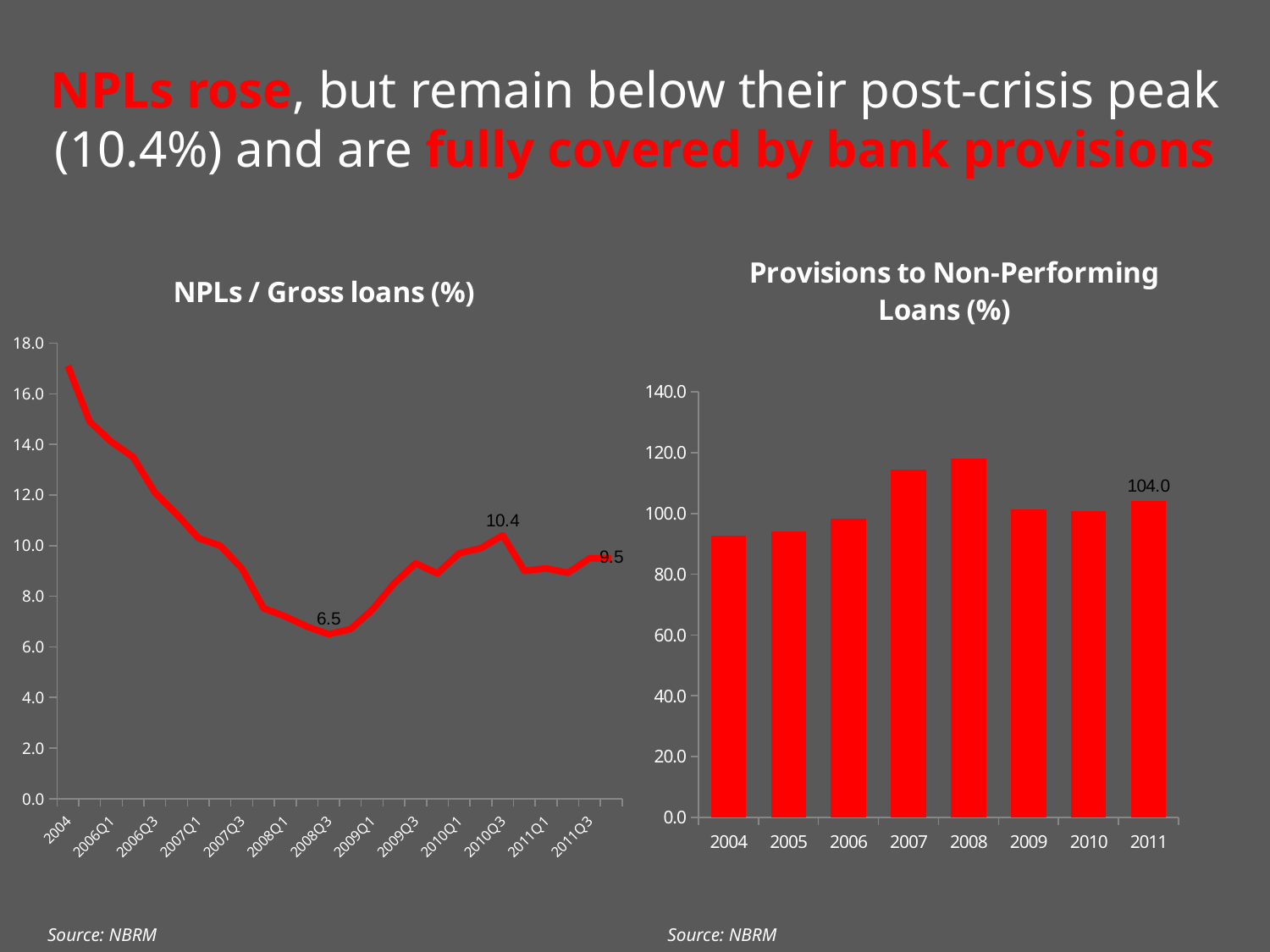
In the 'NPLs / Gross loans (%)' chart, what is the labelled value at the end of the line (2011Q3)? 9.5 How many years are shown in the 'Provisions to Non-Performing Loans (%)' chart? 8 In the 'Provisions to Non-Performing Loans (%)' chart, is the value for 2008 greater or less than 100.0? greater In the 'Provisions to Non-Performing Loans (%)' chart, which is larger, the value for 2007 or the value for 2006? 2007 In the 'Provisions to Non-Performing Loans (%)' chart, what is the value for 2011? 104.0 In the 'Provisions to Non-Performing Loans (%)' chart, which year has the highest bar? 2008 In the 'NPLs / Gross loans (%)' chart, what is the lowest labelled value on the line? 6.5 In the 'Provisions to Non-Performing Loans (%)' chart, is the value for 2004 greater or less than 100.0? less What kind of chart is the 'Provisions to Non-Performing Loans (%)' chart on the right? bar chart In the 'NPLs / Gross loans (%)' chart, what is the difference between the labelled peak of 10.4 and the final value of 9.5? 0.9 What kind of chart is the 'NPLs / Gross loans (%)' chart on the left? line chart In the 'Provisions to Non-Performing Loans (%)' chart, which year has the lowest bar? 2004